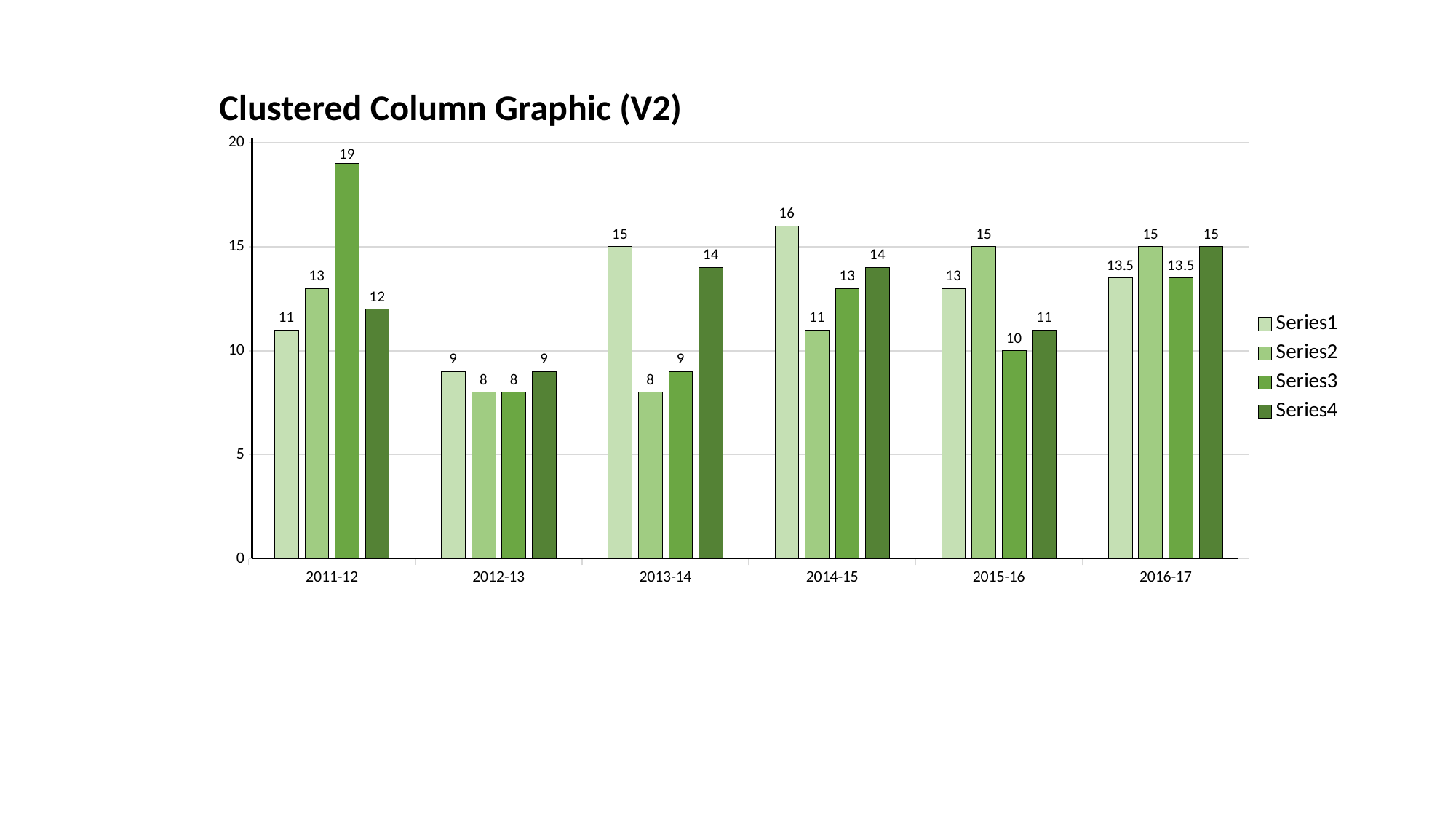
What is the difference between the Series3 and Series4 values for 2011-12? 7 Which category has the lowest Series1 value? 2012-13 What is the value of Series3 for 2011-12? 19 Which is larger for 2015-16, Series2 or Series3? Series2 What is the value of Series1 for 2014-15? 16 What is the title of the chart? Clustered Column Graphic (V2) What is the value of Series2 for 2016-17? 15 Is the value of Series4 for 2013-14 greater or less than 10? greater What kind of chart is shown on the slide? Bar chart How many categories are shown on the x axis? 6 Which category has the highest Series3 value? 2011-12 How many series does the legend list? 4